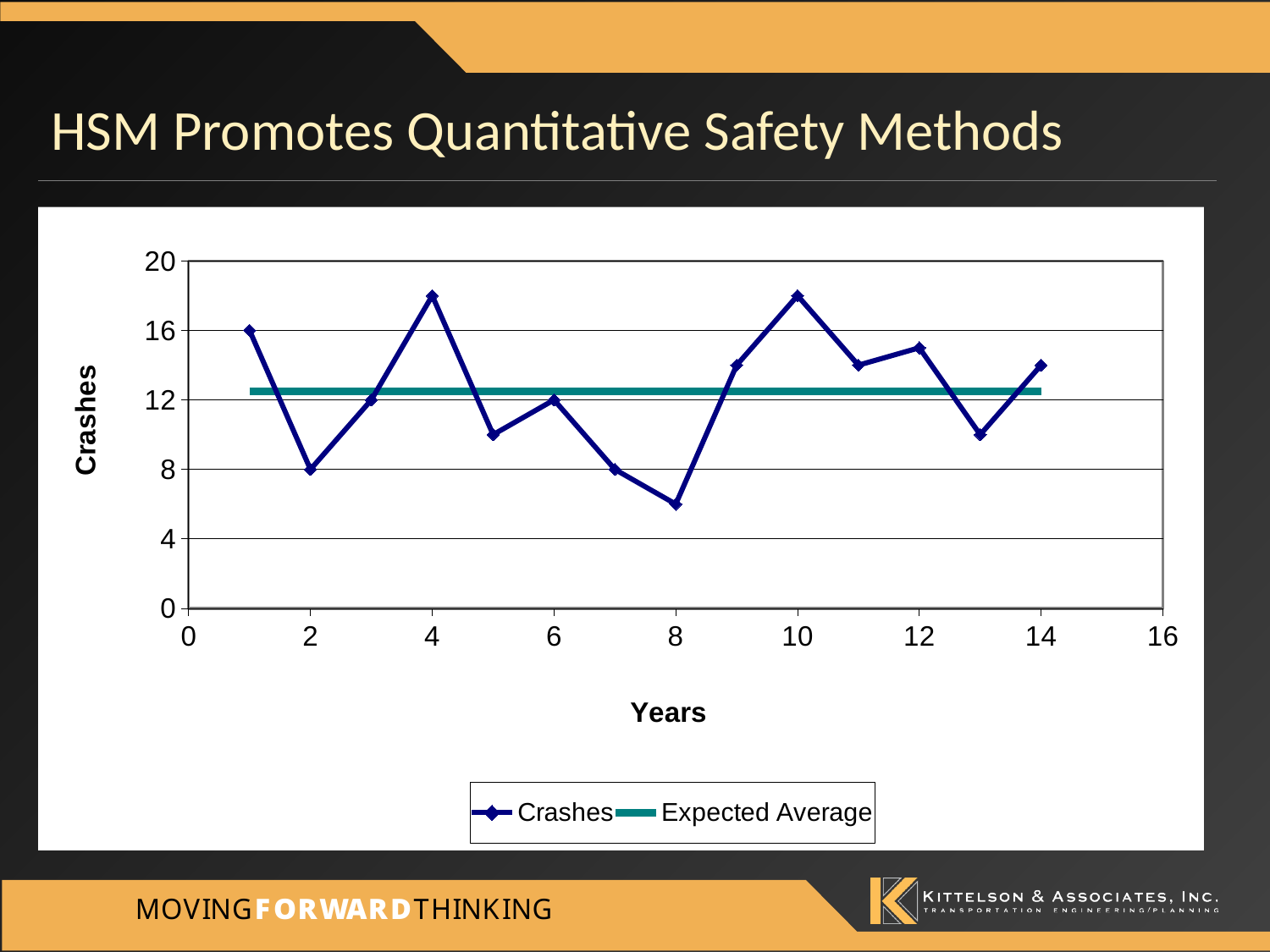
What is the number of crashes in year 1? 16 What are the two series named in the legend? Crashes and Expected Average Which year has more crashes, year 9 or year 13? 9 What is the number of crashes in year 2? 8 Is the number of crashes in year 4 greater or less than 16? greater In which year is the number of crashes lowest? 8 Is the number of crashes in year 8 greater or less than 8? less What is the number of crashes in year 7? 8 How many data points are plotted for the Crashes series? 14 What kind of chart is shown on the slide? line chart How many series does the legend list? 2 What is the label of the vertical axis? Crashes